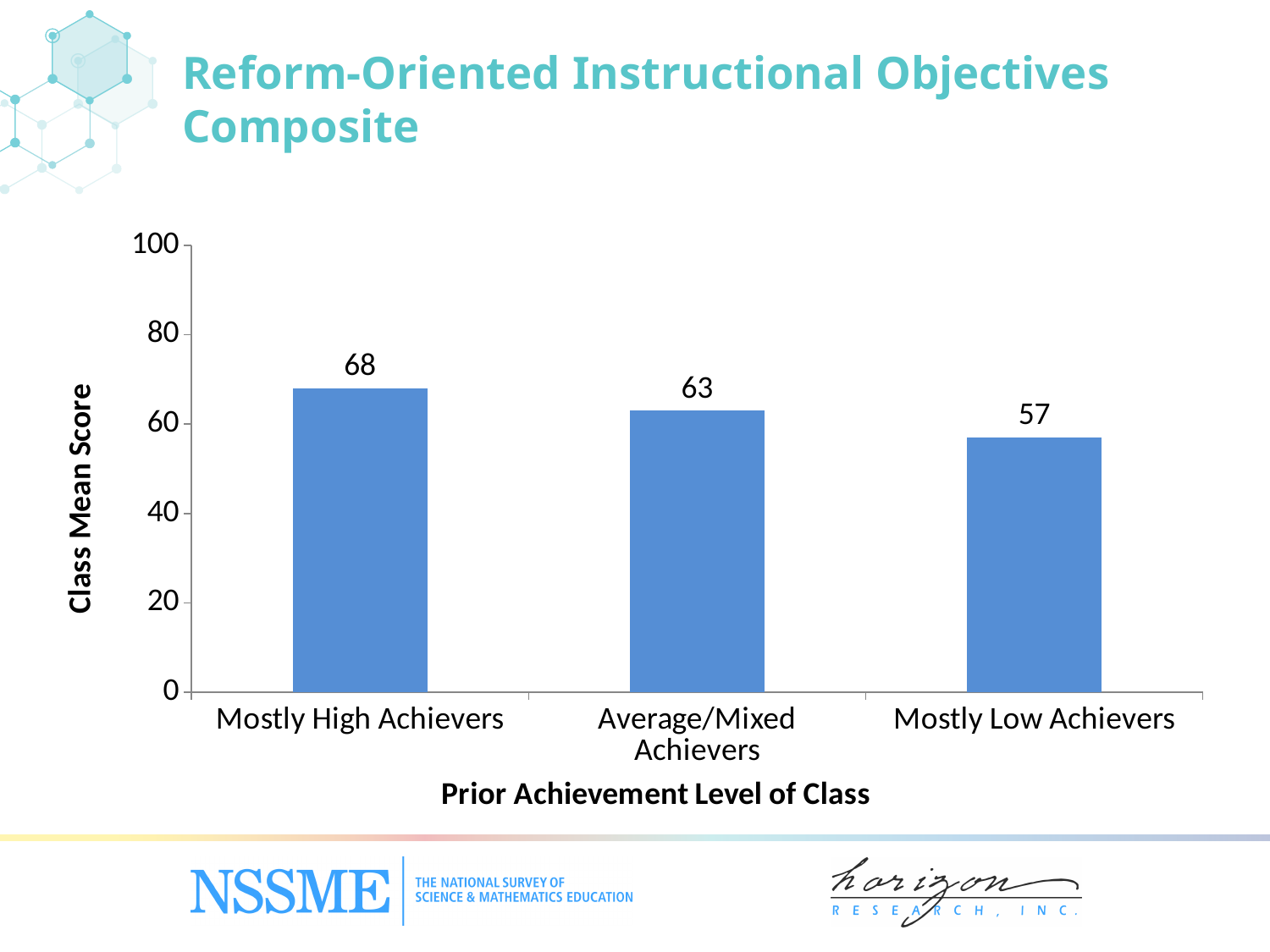
Which prior achievement level has the lowest class mean score? Mostly Low Achievers What is the class mean score for Mostly High Achievers? 68 What kind of chart is shown on the slide? Bar chart What is the difference between the class mean scores for Mostly High Achievers and Mostly Low Achievers? 11 How many prior achievement level categories are shown on the chart? 3 What is the difference between the class mean scores for Average/Mixed Achievers and Mostly Low Achievers? 6 Which has a higher class mean score, Mostly High Achievers or Average/Mixed Achievers? Mostly High Achievers Is the value for Mostly Low Achievers greater or less than 60? less Which prior achievement level has the highest class mean score? Mostly High Achievers What is the class mean score for Average/Mixed Achievers? 63 Do the class mean scores rise or fall moving from Mostly High Achievers to Mostly Low Achievers? Fall What is the class mean score for Mostly Low Achievers? 57